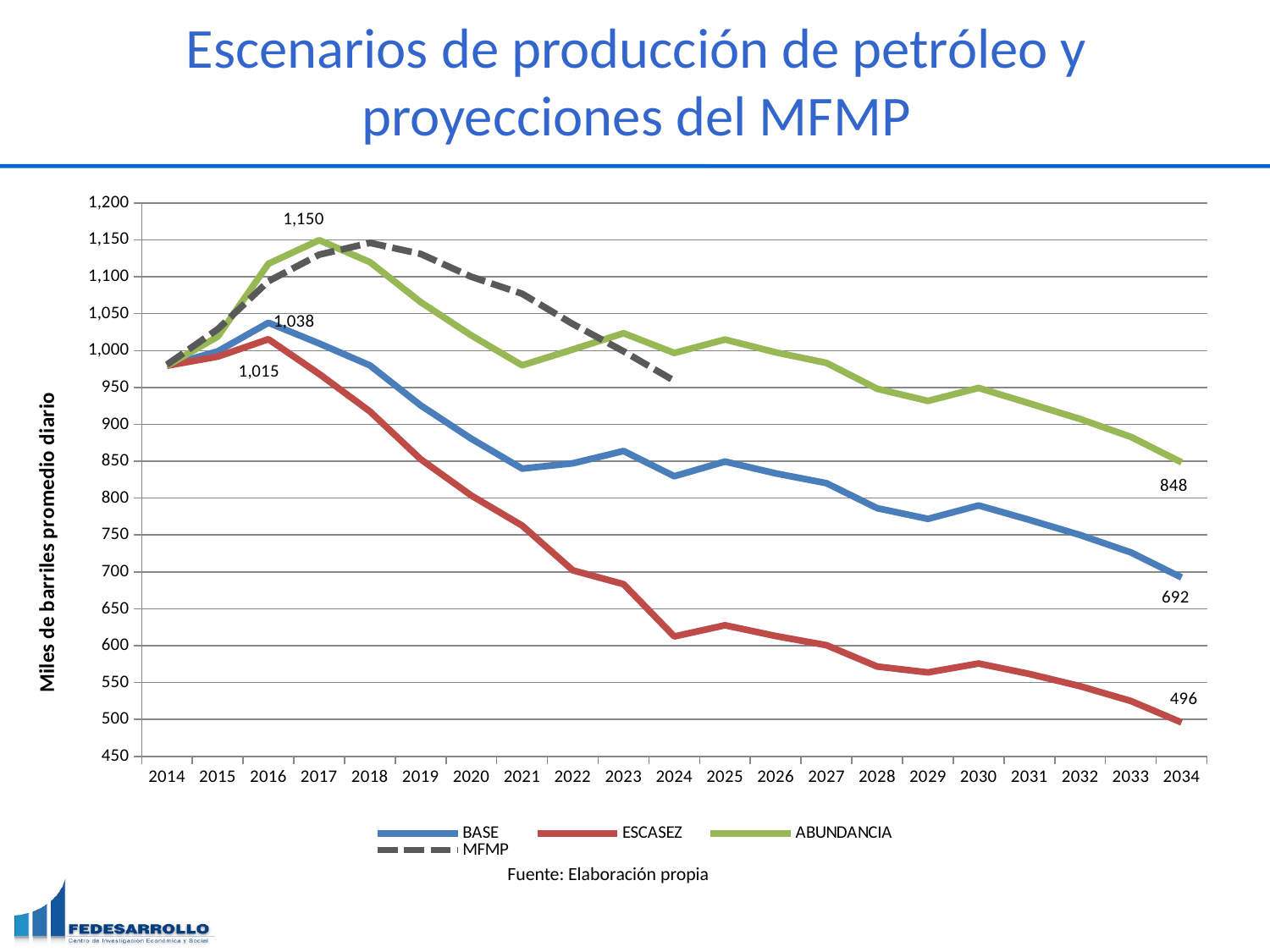
Does the ESCASEZ series rise or fall from 2016 to 2034? fall What is the value of the ABUNDANCIA series in 2017? 1,150 What is the value of the ESCASEZ series in 2034? 496 Is the value of the BASE series in 2021 greater or less than 900? less What is the difference between the BASE and ESCASEZ values in 2016? 23 What is the value of the ESCASEZ series in 2016? 1,015 How many series does the legend list? 4 Which series has the lowest value in 2034? ESCASEZ What kind of chart is shown on the slide? line chart What is the label of the y axis? Miles de barriles promedio diario What is the value of the BASE series in 2016? 1,038 What is the difference between the ABUNDANCIA and BASE values in 2034? 156